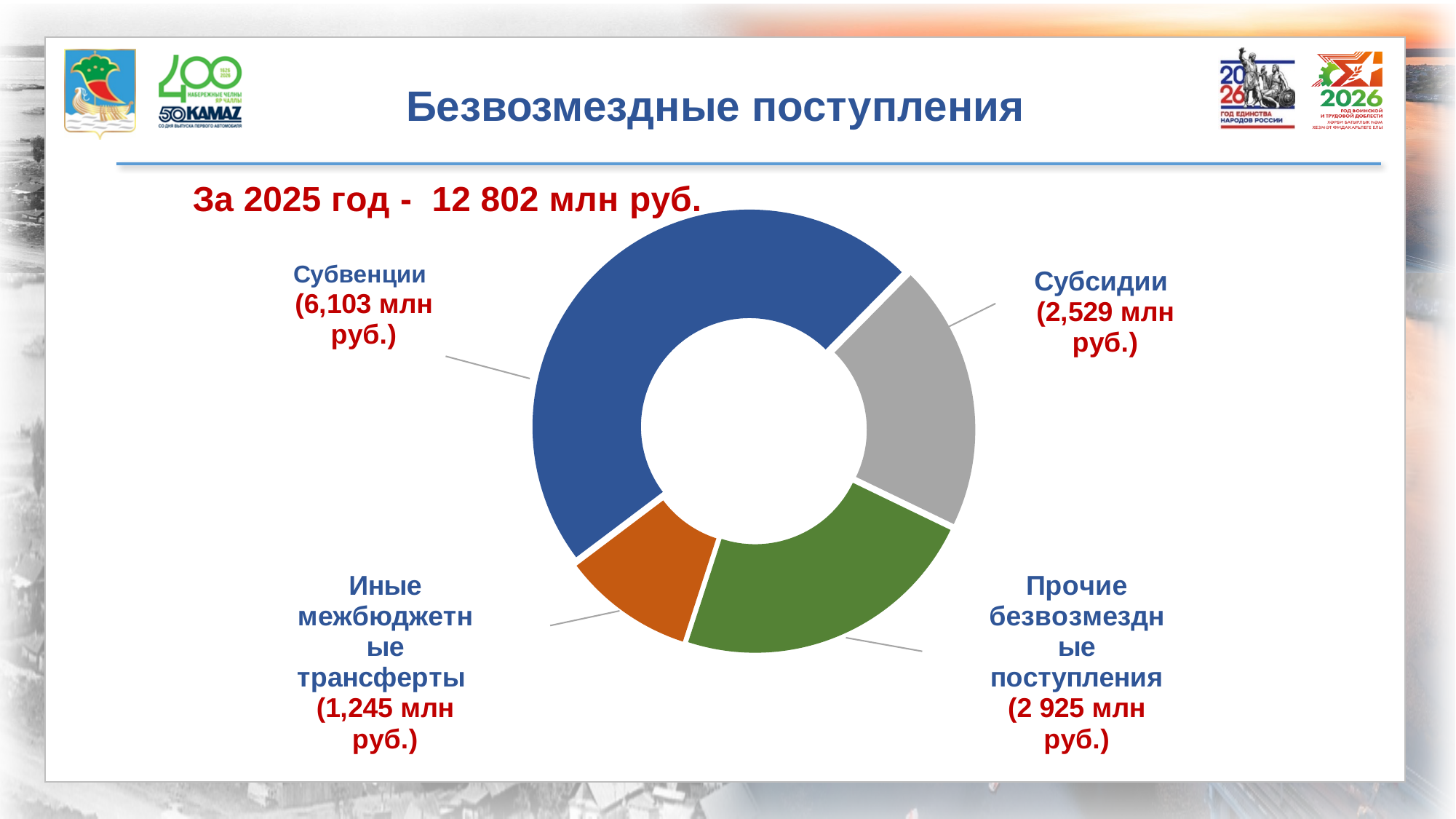
Which category has the smallest value? Иные межбюджетные трансферты What colour is the Субвенции segment of the donut chart? Blue Which category has the largest value? Субвенции What type of chart is shown on the slide? Donut (pie) chart How many categories does the donut chart show? 4 What is the total of all categories for 2025 as stated on the slide? 12 802 млн руб. What is the value for Субсидии? 2,529 млн руб. What is the value for Иные межбюджетные трансферты? 1,245 млн руб. What is the value for Прочие безвозмездные поступления? 2 925 млн руб. What is the value for Субвенции? 6,103 млн руб. What is the difference between Субвенции and Субсидии? 3,574 млн руб. Which is larger: Прочие безвозмездные поступления or Субсидии? Прочие безвозмездные поступления